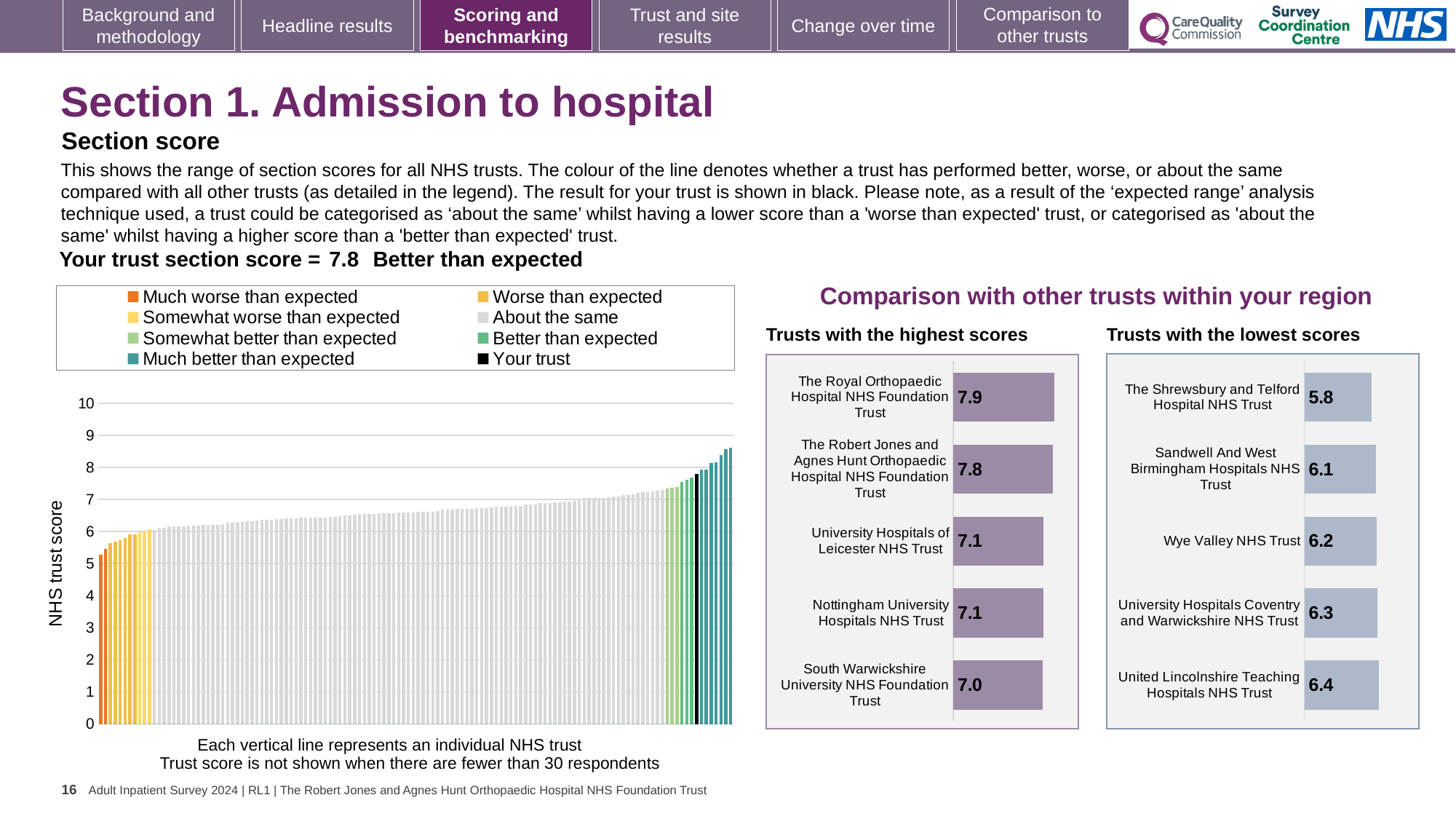
What kind of chart is the 'Trusts with the highest scores' chart? Bar chart In the 'Trusts with the highest scores' chart, which trust has the highest score? The Royal Orthopaedic Hospital NHS Foundation Trust In the 'Trusts with the highest scores' chart, what is the score for The Royal Orthopaedic Hospital NHS Foundation Trust? 7.9 How many trusts are shown in the 'Trusts with the lowest scores' chart? 5 How many entries does the legend of the main NHS trust score chart on the left list? 8 In the 'Trusts with the lowest scores' chart, what is the difference between the scores of United Lincolnshire Teaching Hospitals NHS Trust and The Shrewsbury and Telford Hospital NHS Trust? 0.6 In the 'Trusts with the lowest scores' chart, which has the larger score: Sandwell And West Birmingham Hospitals NHS Trust or University Hospitals Coventry and Warwickshire NHS Trust? University Hospitals Coventry and Warwickshire NHS Trust In the 'Trusts with the highest scores' chart, what is the difference between the scores of The Royal Orthopaedic Hospital NHS Foundation Trust and University Hospitals of Leicester NHS Trust? 0.8 In the 'Trusts with the lowest scores' chart, what is the score for Wye Valley NHS Trust? 6.2 In the 'Trusts with the highest scores' chart, what is the score for South Warwickshire University NHS Foundation Trust? 7.0 In the 'Trusts with the lowest scores' chart, which trust has the lowest score? The Shrewsbury and Telford Hospital NHS Trust In the main NHS trust score chart on the left, do the values rise or fall from left to right? Rise